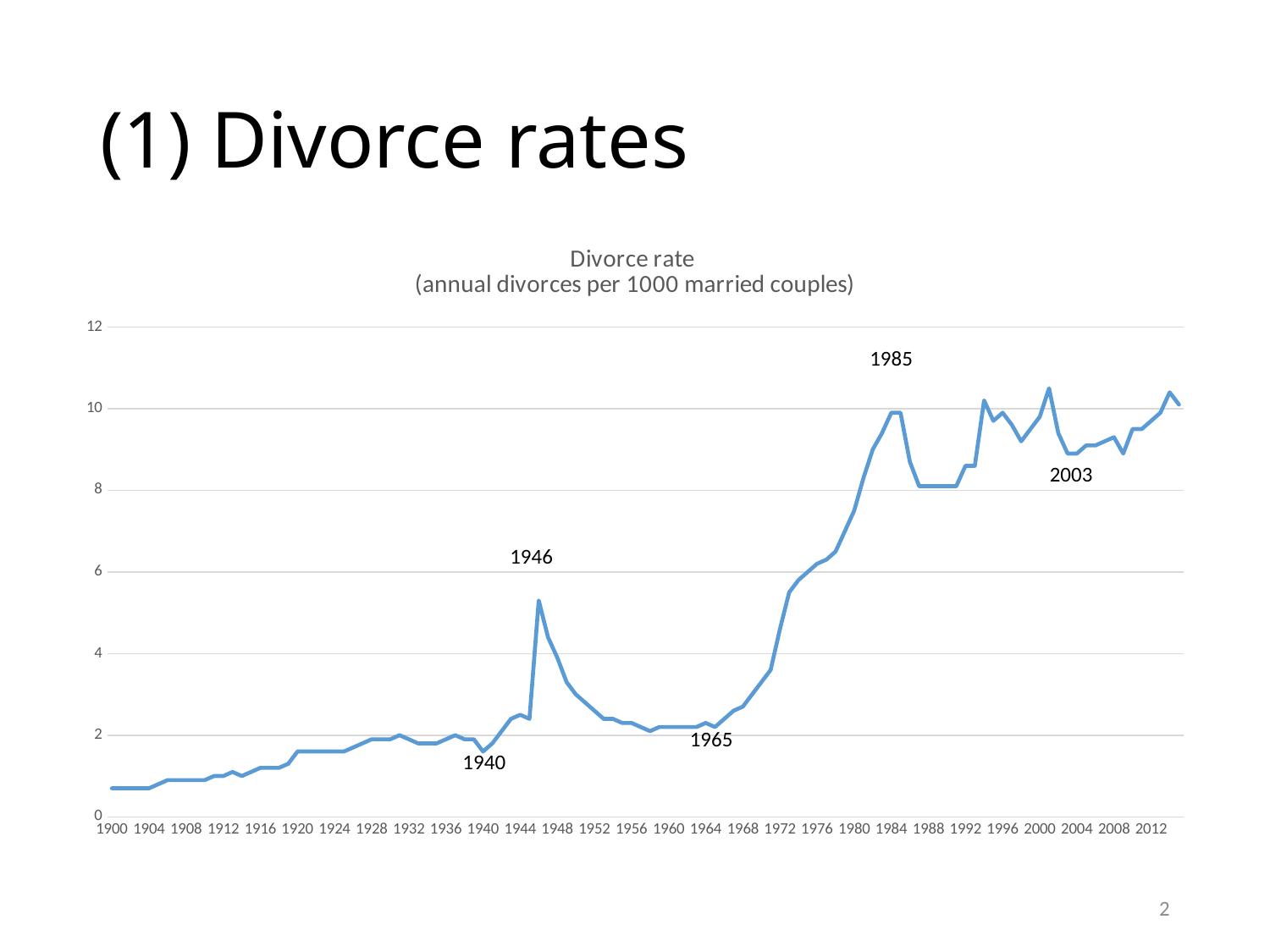
What is the title of the chart? Divorce rate (annual divorces per 1000 married couples) Which years are annotated with labels on the line? 1940, 1946, 1965, 1985, 2003 Is the divorce rate in 1985 greater or less than 8? greater What kind of chart is shown on the slide? line chart Which year has a higher divorce rate, 1946 or 1985? 1985 Is the divorce rate in 1900 greater or less than 2? less Is the divorce rate in 1946 greater or less than 6? less How many years are annotated with labels on the line? 5 Does the divorce rate rise or fall between 1946 and 1965? fall Overall, does the divorce rate rise or fall from 1900 to 2012? rise